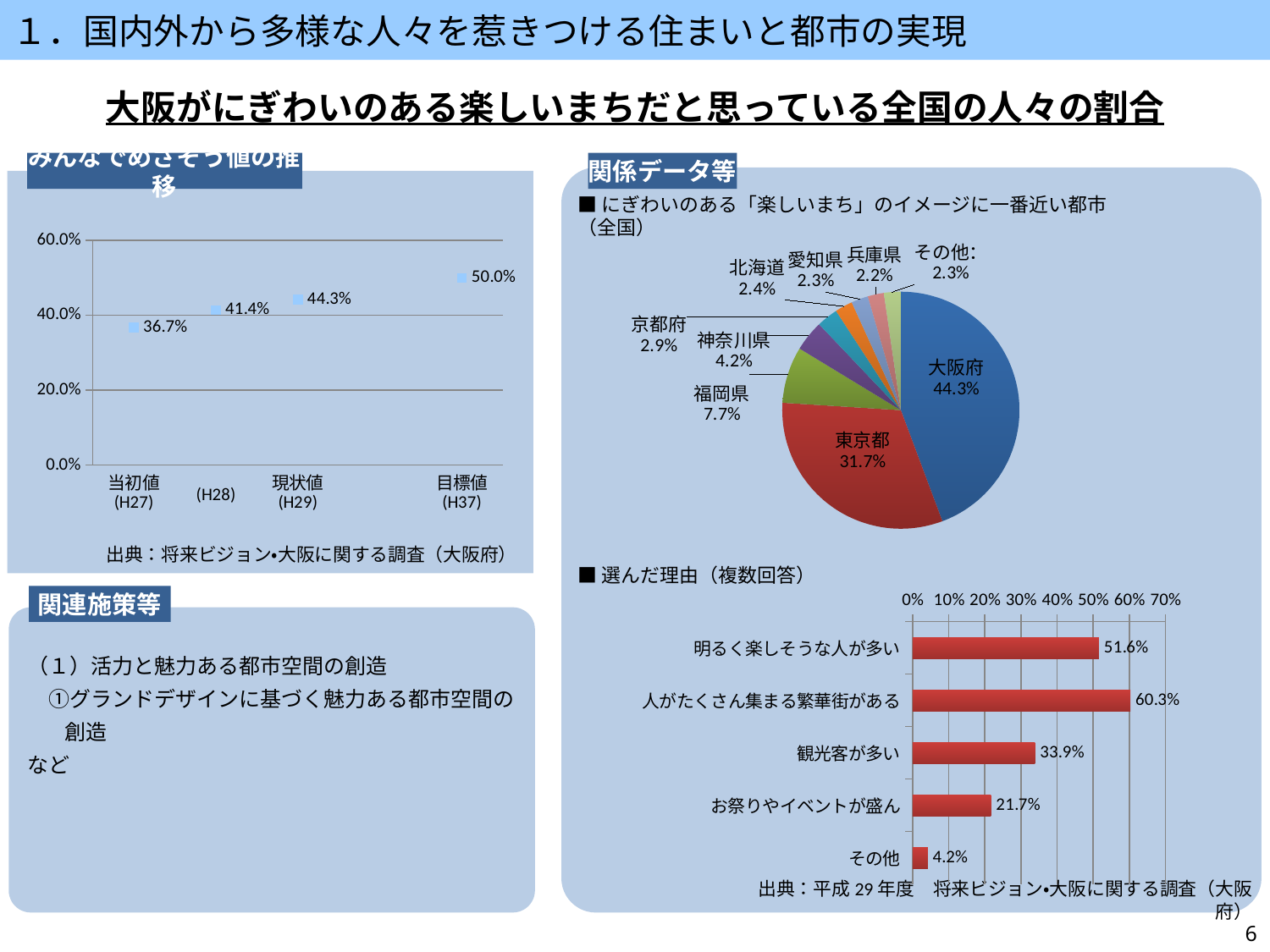
In the bar chart (選んだ理由), which reason has the highest value? 人がたくさん集まる繁華街がある In the chart on the left (みんなでめざそう値の推移), what is the value for 目標値 (H37)? 50.0% What kind of chart is the chart at the bottom right (選んだ理由)? bar chart In the chart on the left (みんなでめざそう値の推移), what is the value for 当初値 (H27)? 36.7% In the pie chart (にぎわいのある「楽しいまち」のイメージに一番近い都市), which prefecture has the largest slice? 大阪府 In the chart on the left (みんなでめざそう値の推移), do the values rise or fall from H27 to H37? rise In the pie chart (にぎわいのある「楽しいまち」のイメージに一番近い都市), how many slices are there? 9 In the pie chart (にぎわいのある「楽しいまち」のイメージに一番近い都市), what is the value for 福岡県? 7.7% In the chart on the left (みんなでめざそう値の推移), what is the difference between the 目標値 (H37) and the 現状値 (H29)? 5.7% In the bar chart (選んだ理由), what is the value for 観光客が多い? 33.9% In the pie chart (にぎわいのある「楽しいまち」のイメージに一番近い都市), what share does 東京都 have? 31.7% In the bar chart (選んだ理由), which is larger: 明るく楽しそうな人が多い or お祭りやイベントが盛ん? 明るく楽しそうな人が多い